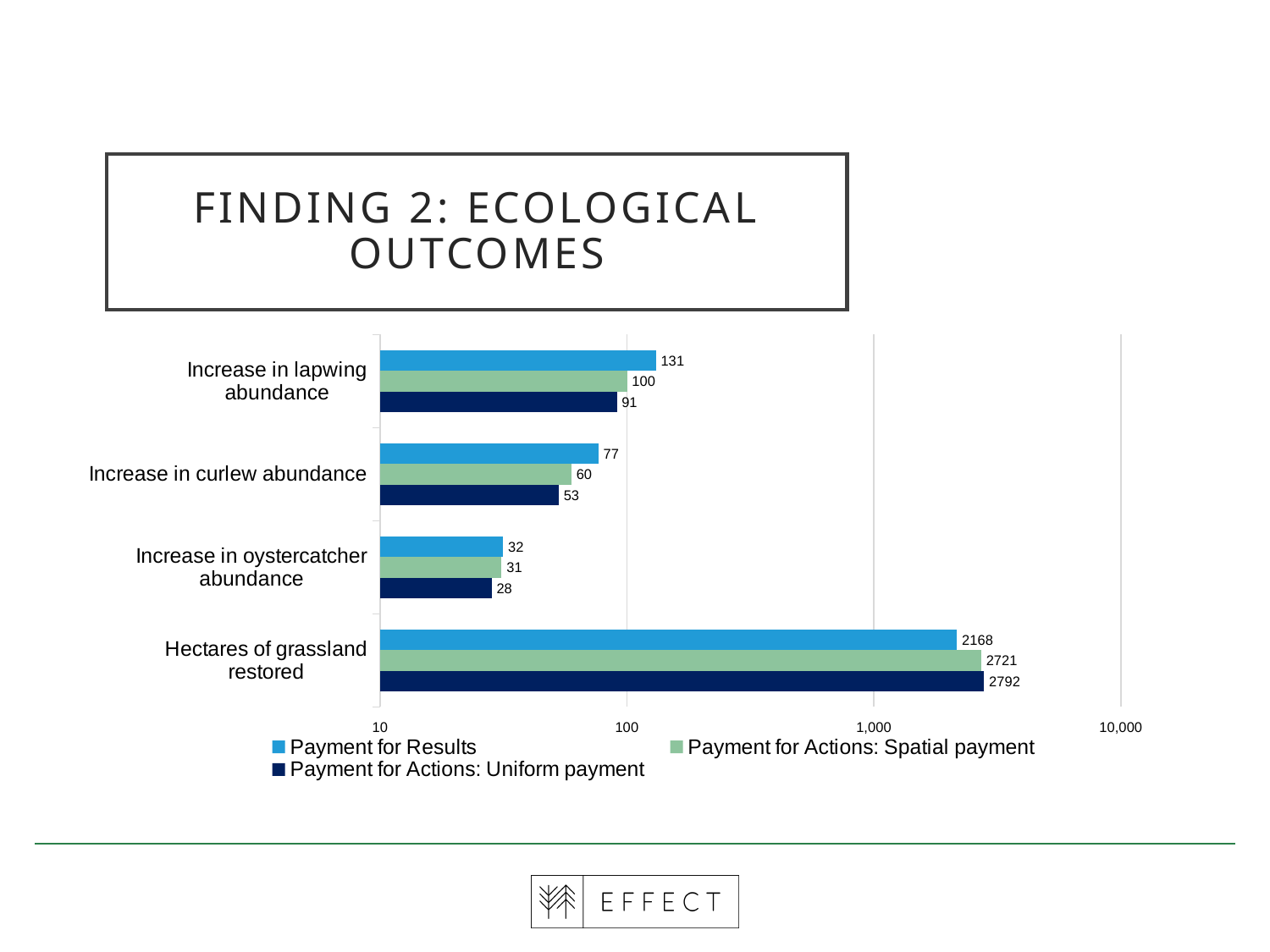
What is the value for Payment for Actions: Uniform payment for Hectares of grassland restored? 2792 What kind of chart is shown on the slide? bar chart How many categories are shown on the chart? 4 How many series does the legend list? 3 What is the value for Payment for Results for Increase in lapwing abundance? 131 Which series is shown in dark navy blue? Payment for Actions: Uniform payment What is the difference between the Payment for Results and Payment for Actions: Uniform payment values for Increase in lapwing abundance? 40 Which category has the highest value for Payment for Results? Hectares of grassland restored Which category has the lowest value for Payment for Actions: Uniform payment? Increase in oystercatcher abundance For Hectares of grassland restored, which is larger: Payment for Results or Payment for Actions: Spatial payment? Payment for Actions: Spatial payment Is the Payment for Results value for Increase in curlew abundance greater or less than 100? less What is the value for Payment for Actions: Spatial payment for Increase in curlew abundance? 60